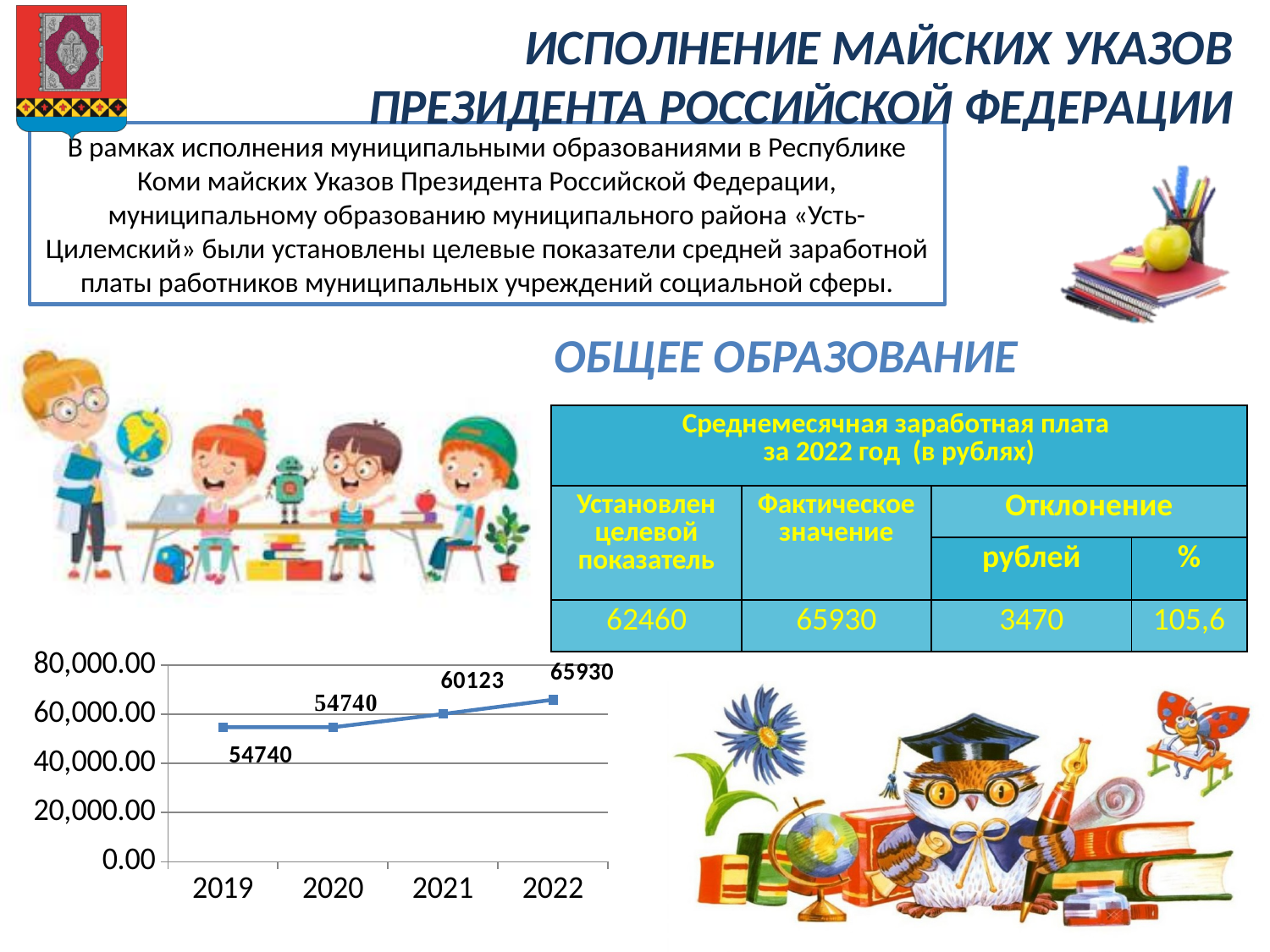
How many years are plotted on the line chart? 4 Which year has the highest value on the line chart? 2022 What is the value for 2021 on the line chart? 60123 Which is larger on the line chart, the value for 2021 or the value for 2020? 2021 What is the difference between the values for 2022 and 2021 on the line chart? 5807 Is the value for 2019 on the line chart greater or less than 60,000.00? less What is the value for 2019 on the line chart? 54740 Is the value for 2022 on the line chart greater or less than 60,000.00? greater What type of chart is shown at the bottom left of the slide? line chart Do the values on the line chart rise or fall from 2020 to 2022? rise What is the value for 2022 on the line chart? 65930 What is the difference between the values for 2021 and 2020 on the line chart? 5383